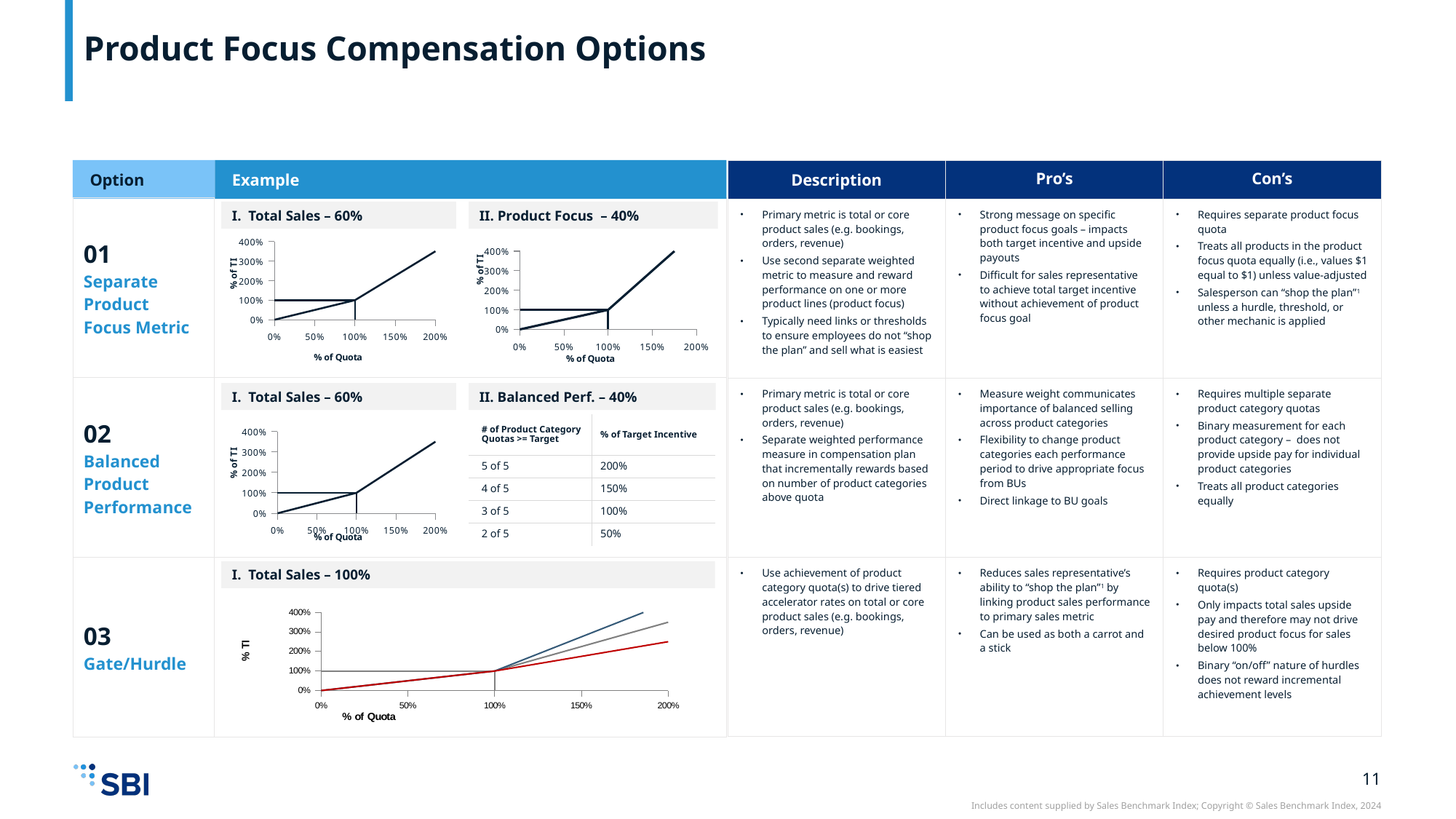
What kind of chart is shown under "I. Total Sales – 60%" for Option 01? Line chart How many lines are plotted in the Option 03 "I. Total Sales – 100%" chart? 3 In the Option 02 "I. Total Sales – 60%" chart, does the % of TI rise or fall as % of Quota increases? Rises In the Option 03 "I. Total Sales – 100%" chart, which line reaches the highest % of TI at the right end: the blue, grey or red line? Blue In the Option 03 "I. Total Sales – 100%" chart, is the red line's % of TI at 200% of Quota greater or less than 200%? greater What is the highest y-axis tick shown on the Option 02 "I. Total Sales – 60%" chart? 400% In the Option 01 "II. Product Focus – 40%" chart, what is the % of TI at 100% of Quota? 100% In the Option 01 "I. Total Sales – 60%" chart, is the % of TI at 200% of Quota greater or less than 300%? greater In the Option 01 "I. Total Sales – 60%" chart, is the % of TI at 50% of Quota greater or less than 100%? less What is the x-axis label of the Option 03 "I. Total Sales – 100%" chart? % of Quota In the Option 01 "I. Total Sales – 60%" chart, what is the % of TI when % of Quota is 100%? 100% In the Option 03 "I. Total Sales – 100%" chart, what is the % of TI at 100% of Quota? 100%